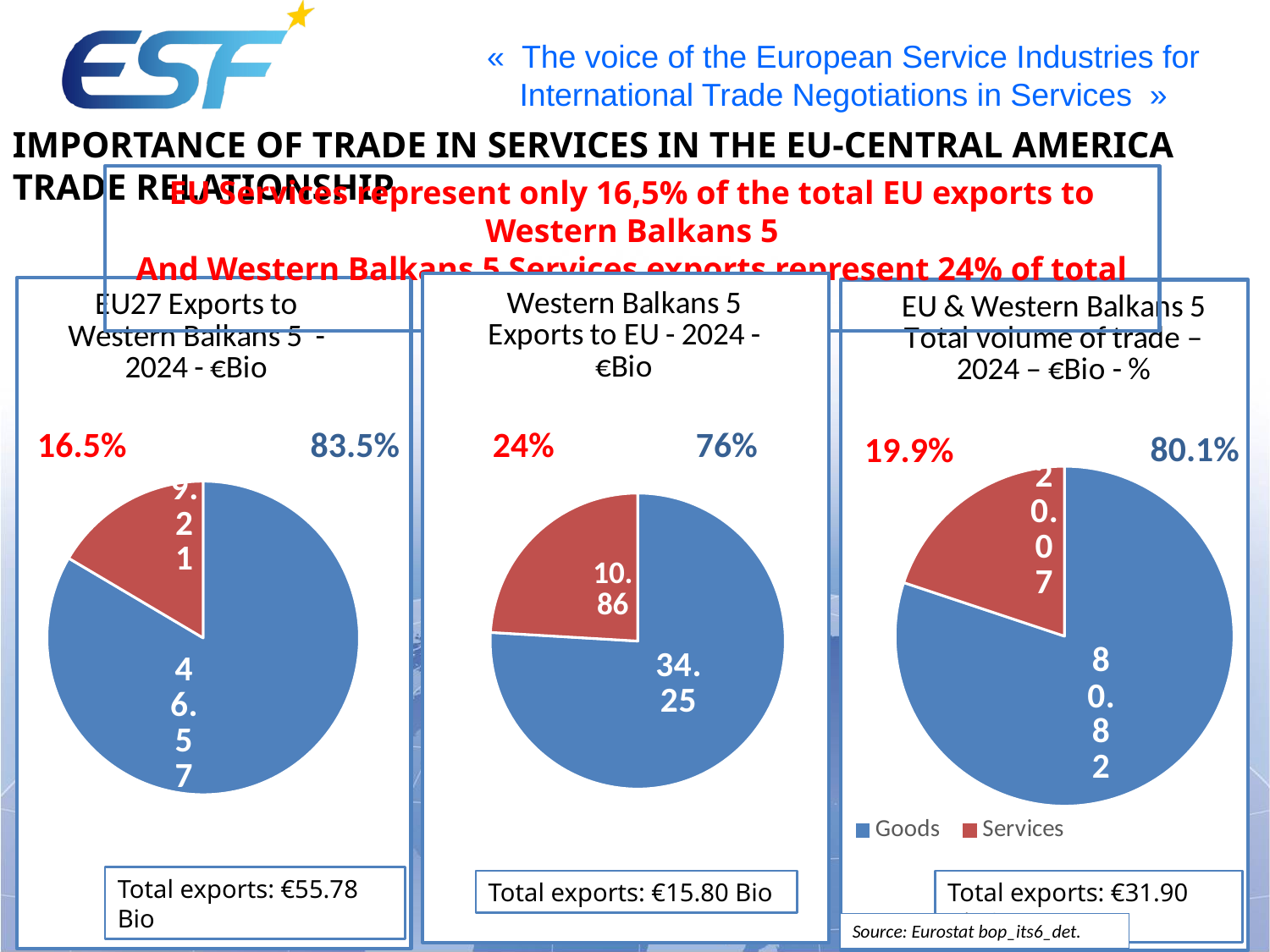
How many series does the legend of the EU & Western Balkans 5 Total volume of trade chart list? 2 In the Western Balkans 5 Exports to EU chart, what is the value shown for Services? 10.86 In the EU27 Exports to Western Balkans 5 chart, what is the value shown for Goods? 46.57 In the EU27 Exports to Western Balkans 5 chart, what percentage share does the Services slice have? 16.5% In the EU & Western Balkans 5 Total volume of trade chart, which colour represents Services in the legend? Red In the Western Balkans 5 Exports to EU chart, what percentage share does the Goods slice have? 76% In the Western Balkans 5 Exports to EU chart, what is the difference between the Goods value and the Services value? 23.39 In the EU & Western Balkans 5 Total volume of trade chart, what is the value shown for Goods? 80.82 In the Western Balkans 5 Exports to EU chart, what is the value shown for Goods? 34.25 In the EU & Western Balkans 5 Total volume of trade chart, what percentage share does the Services slice have? 19.9% What kind of chart is used on this slide for the EU27 Exports to Western Balkans 5 chart? Pie chart In the EU & Western Balkans 5 Total volume of trade chart, which slice is larger, Goods or Services? Goods